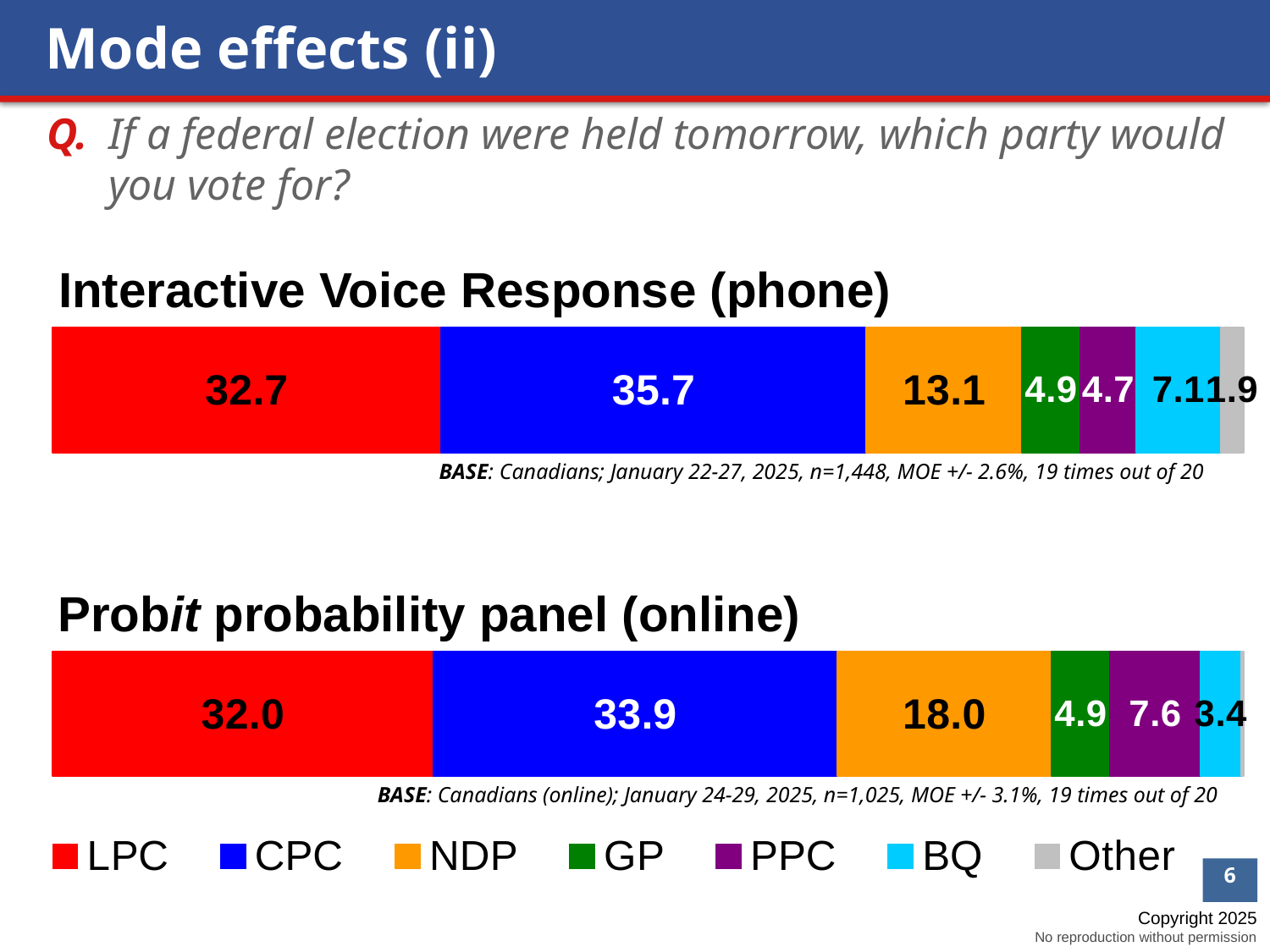
What kind of chart is used for the Interactive Voice Response (phone) results? Stacked bar chart In the Probit probability panel (online) chart, what is the value for NDP? 18.0 How many series does the legend list? 7 In the Interactive Voice Response (phone) chart, what is the difference between the CPC and LPC values? 3.0 In the Probit probability panel (online) chart, what is the difference between the CPC and LPC values? 1.9 In the Probit probability panel (online) chart, which is larger, the value for GP or the value for BQ? GP In the Interactive Voice Response (phone) chart, which party has the highest value? CPC In the Probit probability panel (online) chart, which party has the highest value? CPC In the Interactive Voice Response (phone) chart, what is the value for NDP? 13.1 Is the NDP value larger in the Interactive Voice Response (phone) chart or in the Probit probability panel (online) chart? Probit probability panel (online) In the Interactive Voice Response (phone) chart, what is the value for CPC? 35.7 In the Probit probability panel (online) chart, what is the value for PPC? 7.6